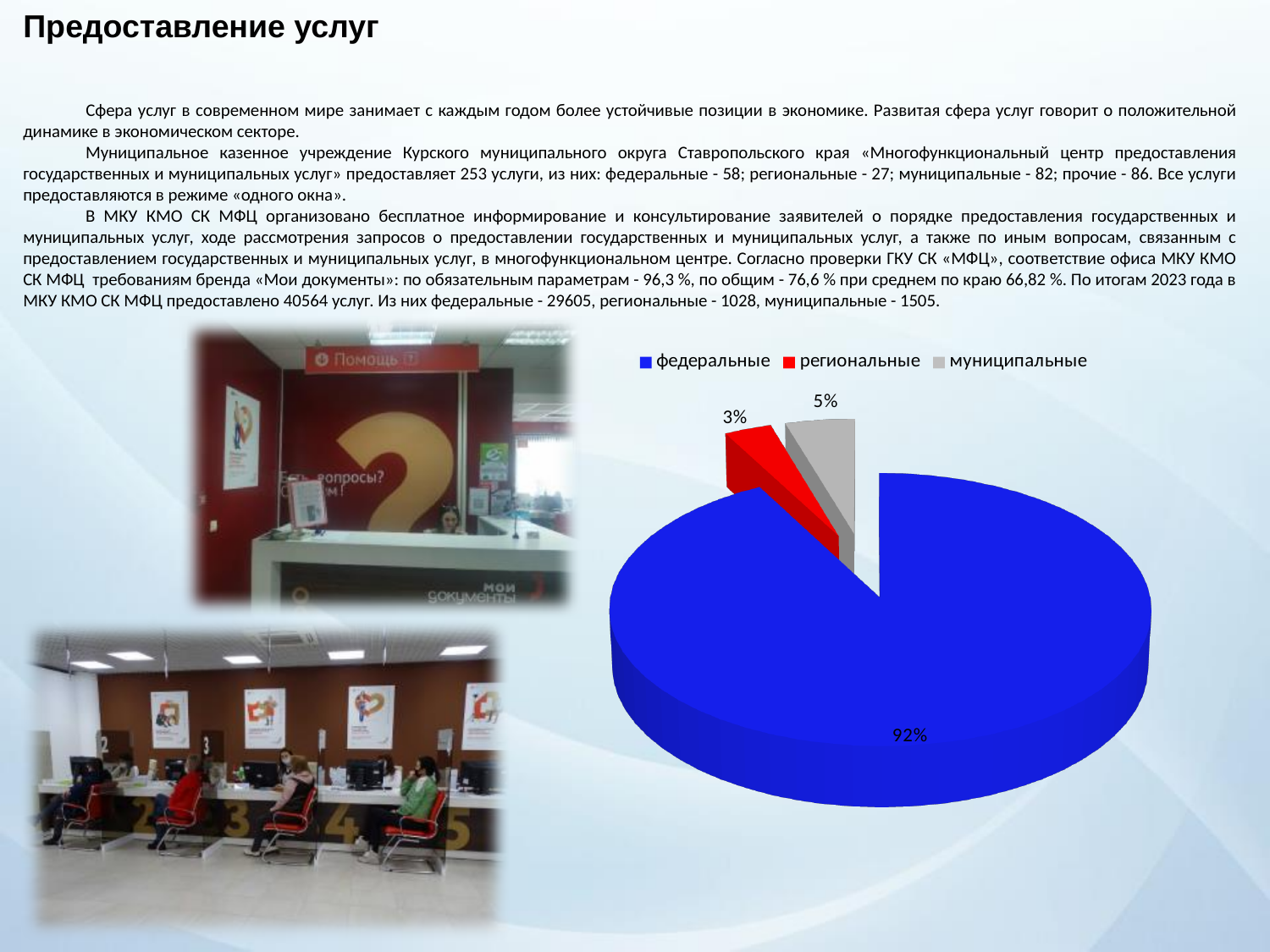
Which category has the smallest slice of the pie? региональные How many entries does the legend list? 3 What is the difference between the муниципальные and региональные shares? 2% What kind of chart is shown on the slide? pie chart What share of the pie does the федеральные slice represent? 92% Which is larger, the муниципальные slice or the региональные slice? муниципальные What is the value shown for муниципальные? 5% What is the value shown for региональные? 3% How many slices does the pie chart have? 3 Which category has the largest slice of the pie? федеральные What colour is the федеральные slice in the pie chart? blue What is the difference between the федеральные and муниципальные shares? 87%